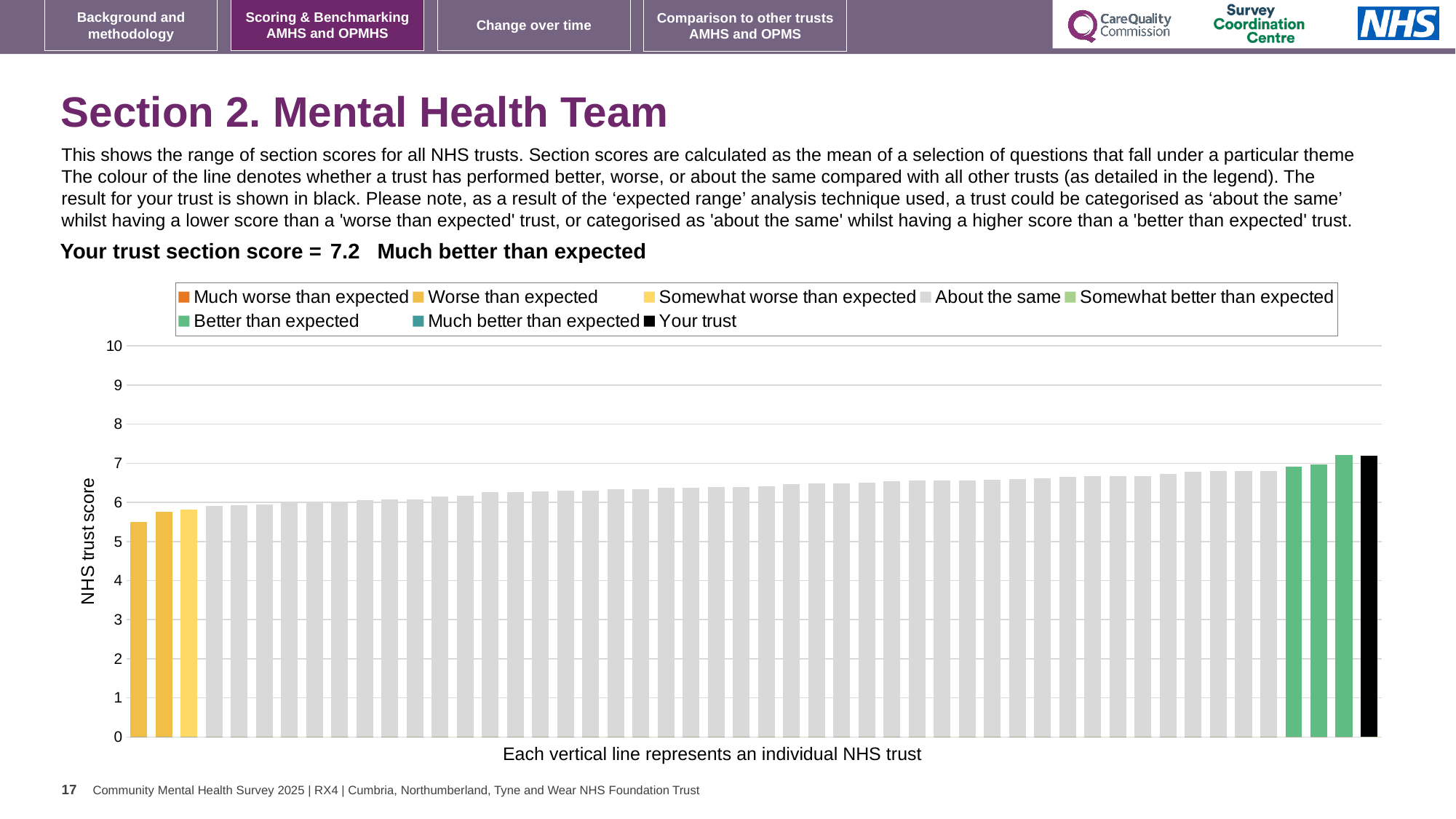
What is the label on the vertical axis of the chart? NHS trust score Is the value of the lowest bar on the chart greater or less than 6? less Is the value of the black 'Your trust' bar greater or less than 7? greater What is the section score for your trust shown on the slide? 7.2 How many entries does the chart legend list? 8 What kind of chart is shown on the slide? bar chart Which performance category is your trust placed in for this section? Much better than expected Do the bar values rise or fall moving from left to right along the x axis? rise What colour is the bar representing your trust? black How many yellow bars are there at the left of the chart? 3 Is the value of the lowest bar on the chart greater or less than 5? greater